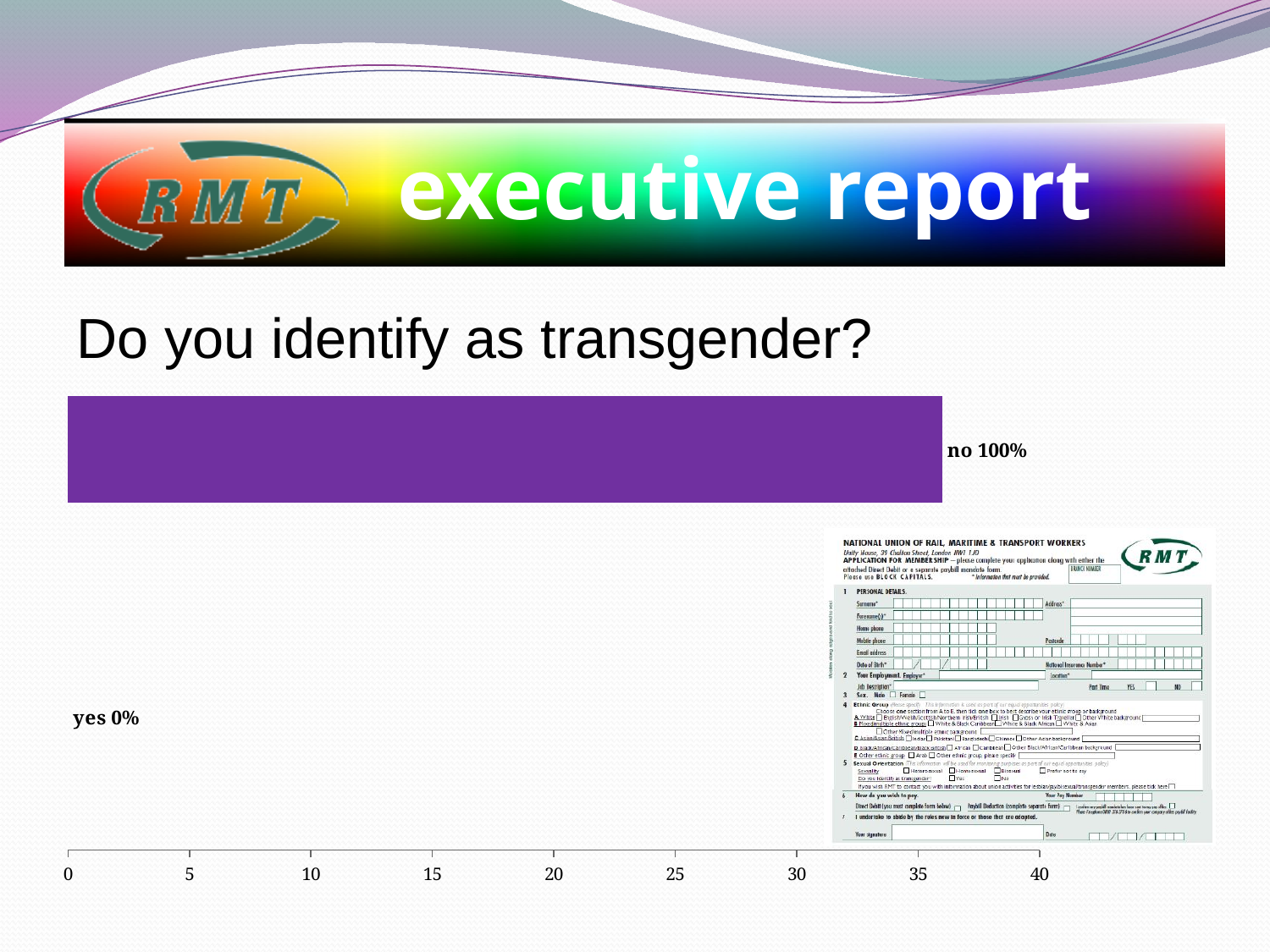
Which category has the highest value? no What question does the chart on the slide address? Do you identify as transgender? What colour is the bar for 'no'? purple What is the data label shown for the 'no' category? 100% What kind of chart is shown on the slide? bar chart Is the bar for 'no' greater or less than 40 on the x axis? less Which is larger, the value for 'no' or the value for 'yes'? no What is the data label shown for the 'yes' category? 0% Which category has the lowest value? yes What is the difference between the percentage labels for 'no' and 'yes'? 100% Is the bar for 'no' greater or less than 30 on the x axis? greater How many categories are shown in the chart? 2